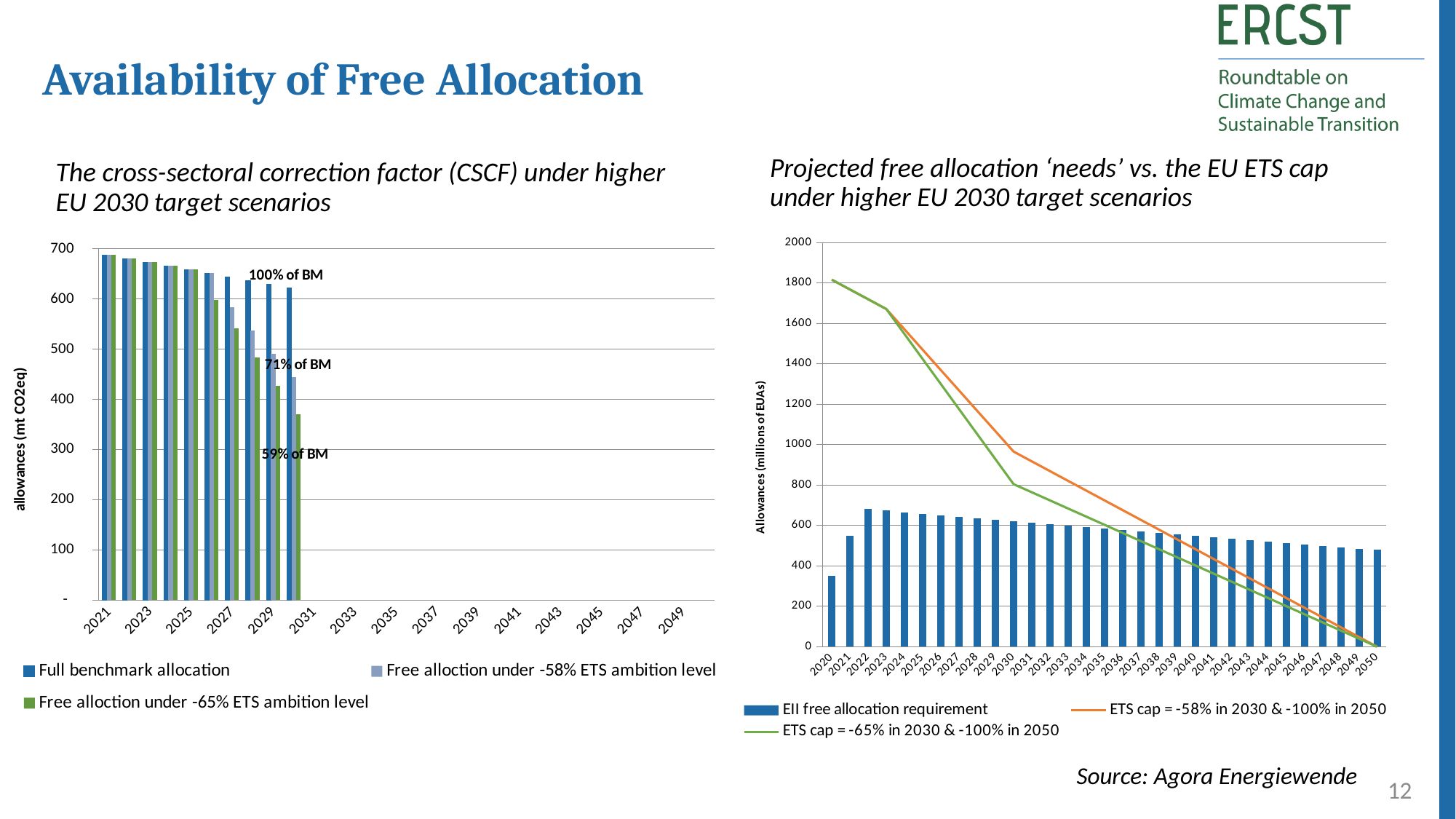
On the left chart (CSCF under higher EU 2030 target scenarios), in 2030, which is larger: Full benchmark allocation or Free allocation under -65% ETS ambition level? Full benchmark allocation On the left chart (CSCF under higher EU 2030 target scenarios), do the Free allocation under -65% ETS ambition level values rise or fall from 2021 to 2030? fall On the right chart (Projected free allocation 'needs' vs. the EU ETS cap), do the ETS cap lines rise or fall from 2020 to 2050? fall On the right chart (Projected free allocation 'needs' vs. the EU ETS cap), how many series does the legend list? 3 On the left chart (CSCF under higher EU 2030 target scenarios), is the Free allocation under -65% ETS ambition level value for 2030 greater or less than 400? less On the left chart (CSCF under higher EU 2030 target scenarios), what percentage of BM is annotated for the lowest series? 59% of BM On the right chart (Projected free allocation 'needs' vs. the EU ETS cap), in 2030, which is higher: ETS cap = -58% in 2030 & -100% in 2050 or ETS cap = -65% in 2030 & -100% in 2050? ETS cap = -58% in 2030 & -100% in 2050 On the right chart (Projected free allocation 'needs' vs. the EU ETS cap), what is the y-axis label? Allowances (millions of EUAs) On the right chart (Projected free allocation 'needs' vs. the EU ETS cap), is the EII free allocation requirement value for 2020 greater or less than 400? less On the left chart (CSCF under higher EU 2030 target scenarios), is the Full benchmark allocation value for 2021 greater or less than 600? greater On the left chart (CSCF under higher EU 2030 target scenarios), what kind of chart is it? bar chart On the left chart (CSCF under higher EU 2030 target scenarios), how many series does the legend list? 3